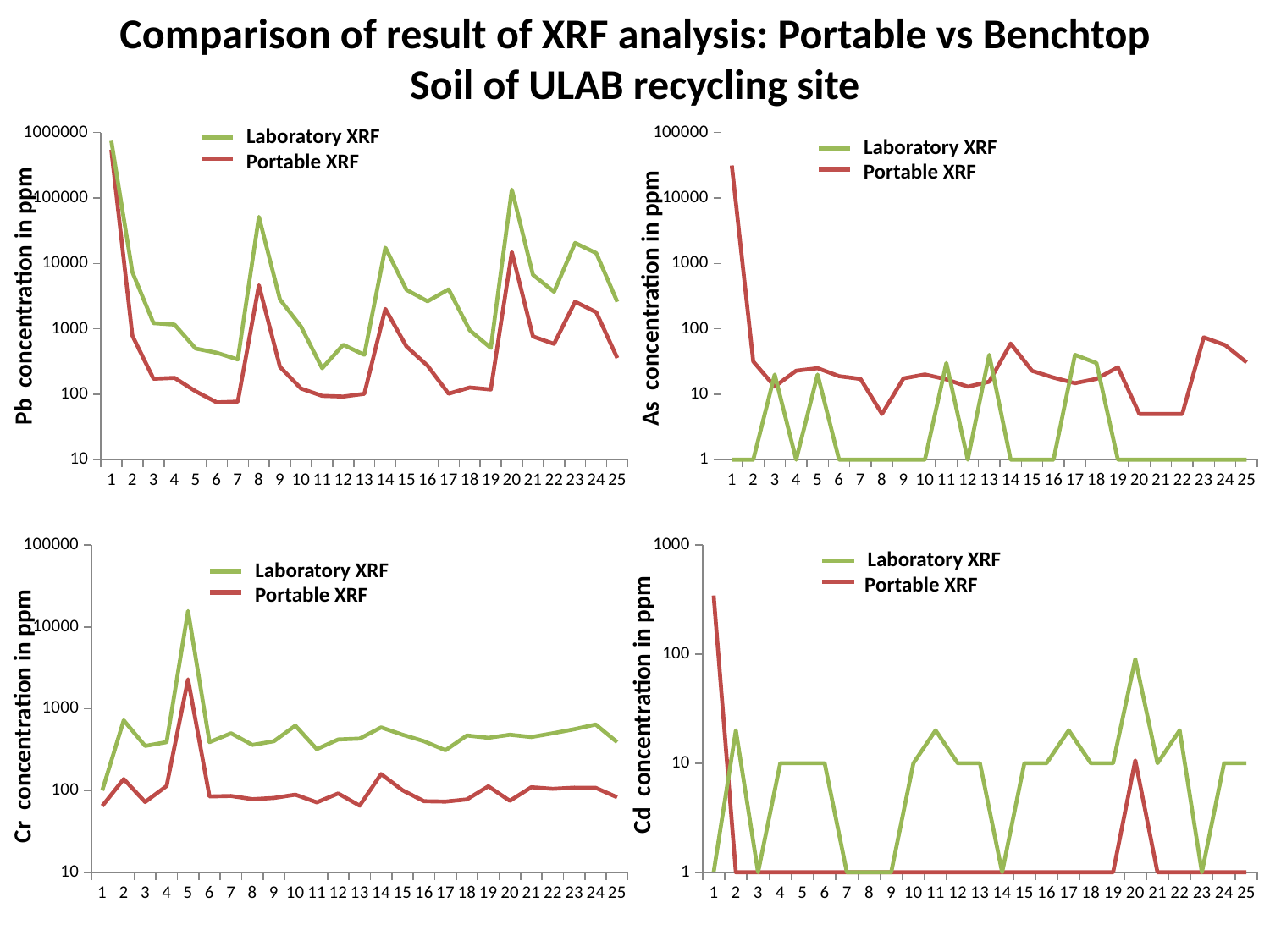
In the Pb concentration chart (top left), is the Laboratory XRF value at sample 1 greater or less than 100000? greater What kind of chart is the Pb concentration chart (top left)? line chart In the Pb concentration chart (top left), at which sample number is the Laboratory XRF value highest? 1 In the Pb concentration chart (top left), is the Portable XRF value at sample 20 greater or less than 10000? greater In the Cd concentration chart (bottom right), at which sample number is the Laboratory XRF value highest? 20 What colour is the Laboratory XRF line in the charts on this slide? green In the Cr concentration chart (bottom left), is the Laboratory XRF value at sample 5 greater or less than 10000? greater In the Pb concentration chart (top left), at sample 8, which series has the higher value, Laboratory XRF or Portable XRF? Laboratory XRF How many series does the legend of the Pb concentration chart (top left) list? 2 In the Cr concentration chart (bottom left), at which sample number is the Portable XRF value highest? 5 How many sample points are plotted along the x axis of the Cr concentration chart (bottom left)? 25